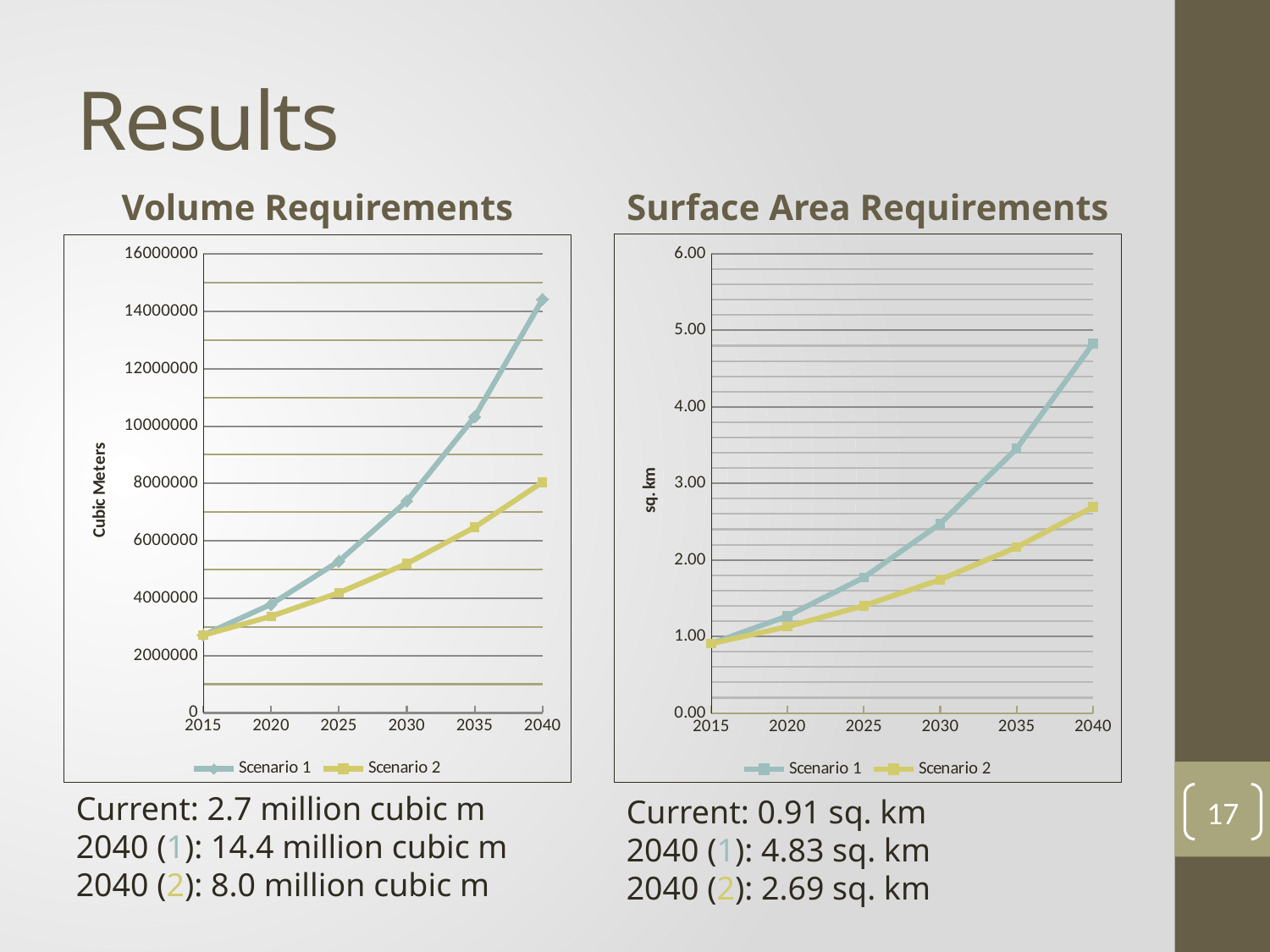
What kind of chart is the Volume Requirements chart? line chart In the Volume Requirements chart, is the Scenario 1 value for 2040 greater or less than 14000000? greater According to the text under the Volume Requirements chart, what is the 2040 value for Scenario 2? 8.0 million cubic m In the Volume Requirements chart, is the Scenario 2 value for 2030 greater or less than 6000000? less In the Surface Area Requirements chart, which scenario has the higher value in 2040? Scenario 1 According to the text under the Surface Area Requirements chart, what is the 2040 value for Scenario 1? 4.83 sq. km In the Surface Area Requirements chart, is the Scenario 1 value for 2035 greater or less than 3.00? greater How many series does the legend of the Surface Area Requirements chart list? 2 In the Volume Requirements chart, do the Scenario 1 values rise or fall from 2015 to 2040? rise How many years are marked on the x axis of the Volume Requirements chart? 6 What is the y-axis label of the Surface Area Requirements chart? sq. km